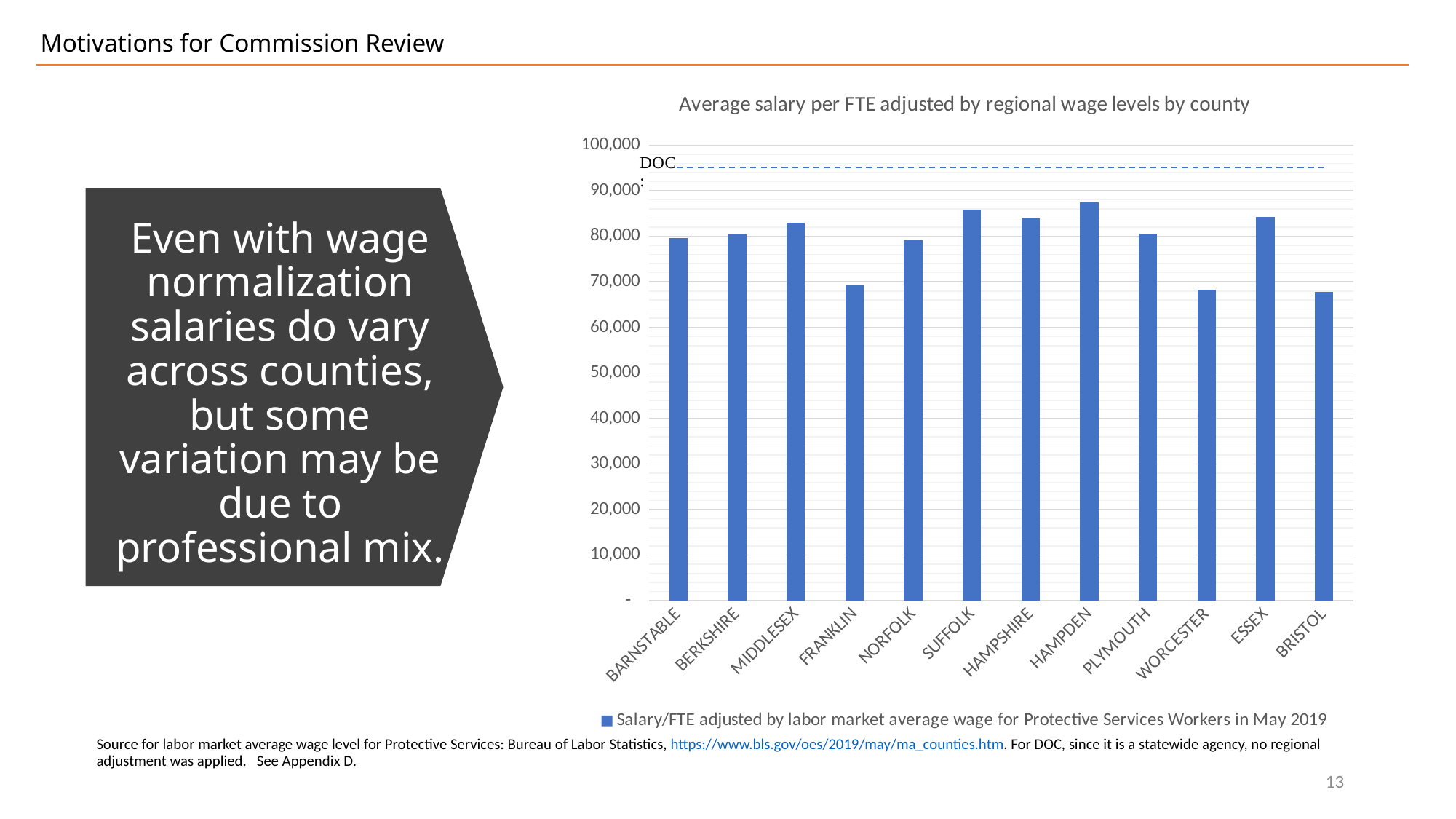
Is the value for Hampden greater or less than 80,000? greater Which county has the highest adjusted average salary per FTE? Hampden Is the value for Worcester greater or less than 70,000? less Is the value for Essex greater or less than 80,000? greater What is the title of the chart? Average salary per FTE adjusted by regional wage levels by county How many counties are shown on the x axis of the chart? 12 Which is larger, the value for Bristol or the value for Middlesex? Middlesex How many series does the chart legend list? 1 What label is attached to the dashed horizontal line near the top of the chart? DOC Which is larger, the value for Suffolk or the value for Franklin? Suffolk What type of chart is shown on the slide? Bar chart